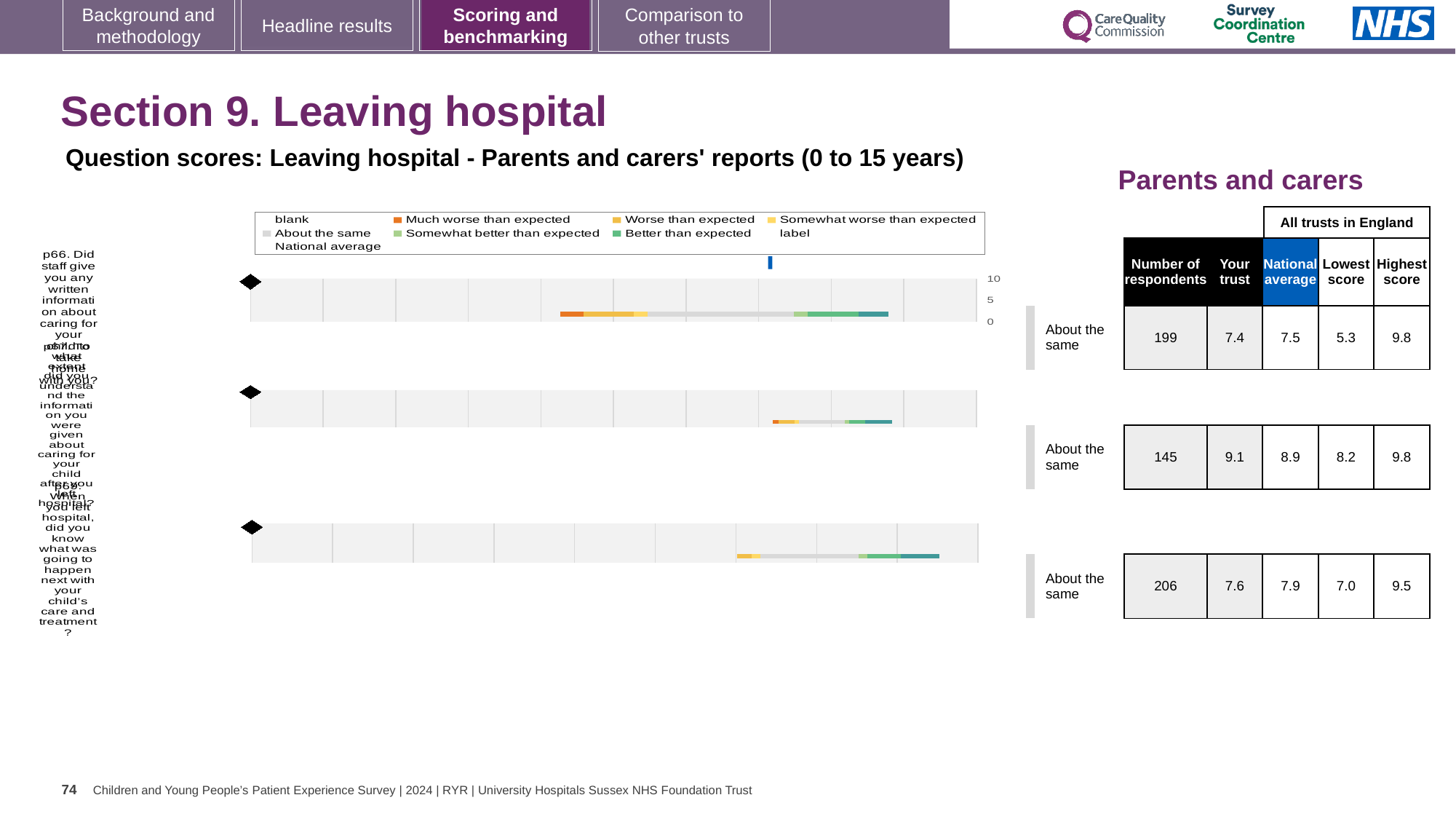
Which legend entry is shown in dark teal in the chart legend? Better than expected What is the first legend entry shown in orange in the chart legend? Much worse than expected For the bottom chart row, what is the national average shown in the table? 7.9 For the top chart row, how many respondents are listed in the table? 199 For the middle chart row, what is the 'Your trust' score shown in the table? 9.1 How many benchmark bar charts are shown on the slide? 3 What kind of chart is used to show the benchmarking for each question on this slide? bar chart For the middle chart row, what is the difference between the 'Your trust' score and the national average? 0.2 Which chart row has the highest 'Your trust' score: top, middle or bottom? middle What benchmark category is given for all three chart rows? About the same For the top chart row, what is the 'Your trust' score shown in the table? 7.4 For the bottom chart row, is the 'Your trust' score or the national average larger? National average